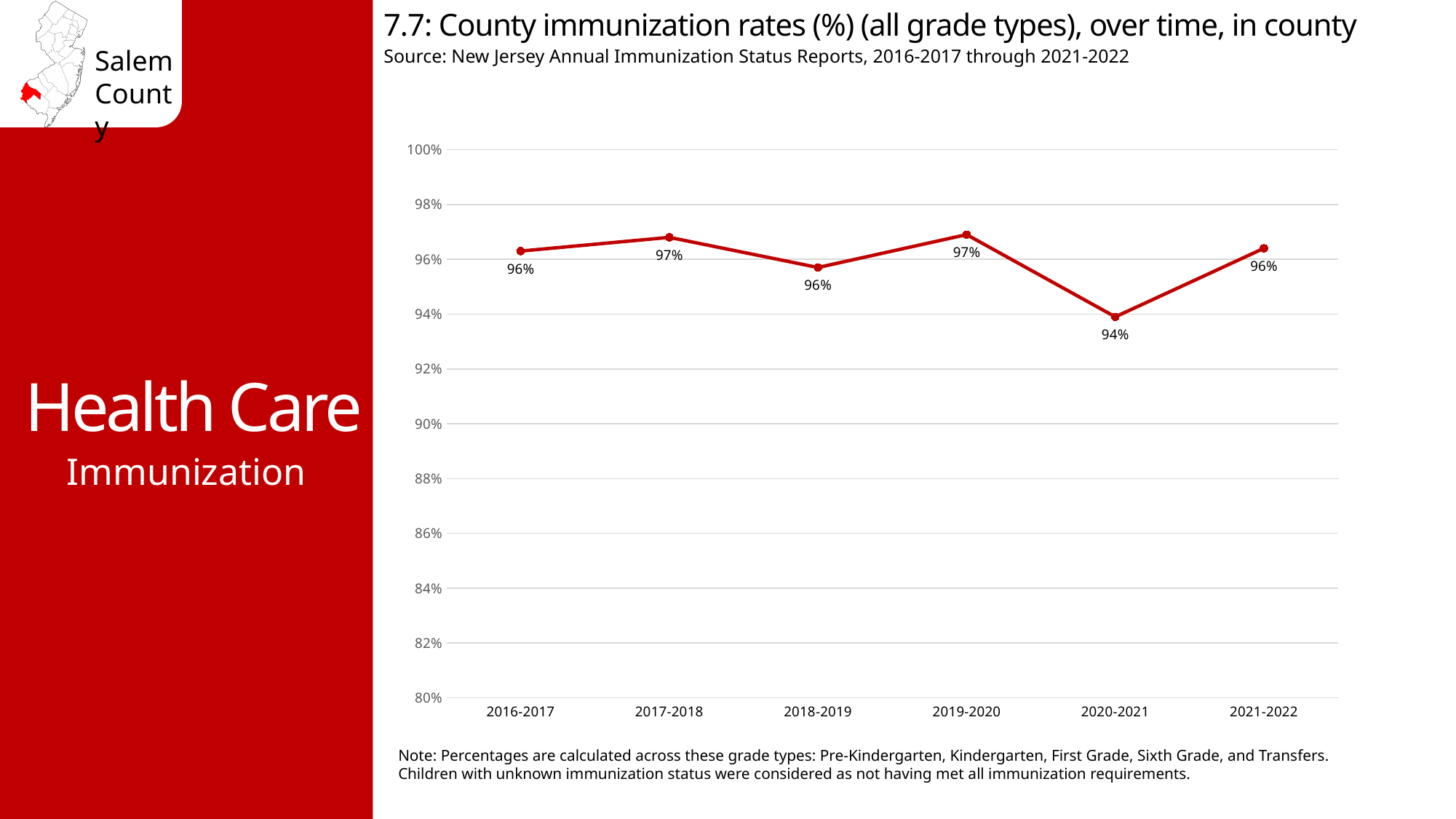
How many school years are plotted on the chart? 6 What is the title of the chart? 7.7: County immunization rates (%) (all grade types), over time, in county Is the value for 2020-2021 greater or less than 96%? less Which is larger, the immunization rate for 2017-2018 or for 2020-2021? 2017-2018 Which school year has the lowest immunization rate? 2020-2021 Does the immunization rate rise or fall from 2019-2020 to 2020-2021? Fall What kind of chart is shown on the slide? Line chart What is the county immunization rate for 2021-2022? 96% What is the county immunization rate for 2019-2020? 97% What is the county immunization rate for 2016-2017? 96% What is the county immunization rate for 2020-2021? 94% What is the difference between the immunization rate in 2019-2020 and in 2020-2021? 3 percentage points